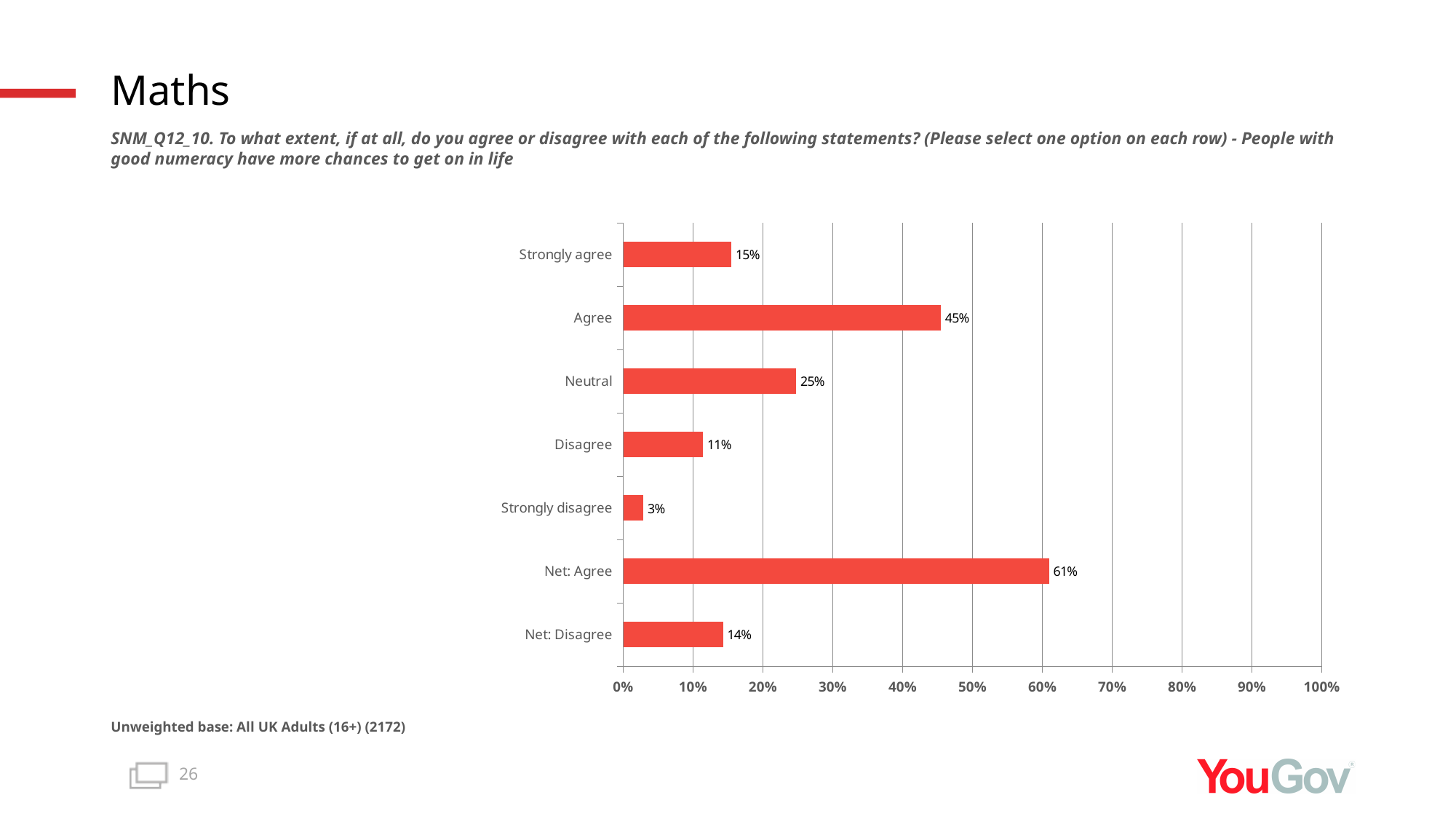
What is the value for 'Net: Disagree'? 14% Is the value for 'Neutral' greater or less than 20%? greater Which category has the lowest value? Strongly disagree What is the unweighted base stated below the chart? All UK Adults (16+) (2172) Which category has the highest value? Net: Agree How many categories are shown on the chart? 7 What percentage of respondents selected 'Agree'? 45% What is the value shown for 'Strongly disagree'? 3% Which is larger, 'Strongly agree' or 'Disagree'? Strongly agree What is the difference between 'Agree' and 'Neutral'? 20% What kind of chart is shown on the slide? Bar chart What is the difference between 'Net: Agree' and 'Net: Disagree'? 47%